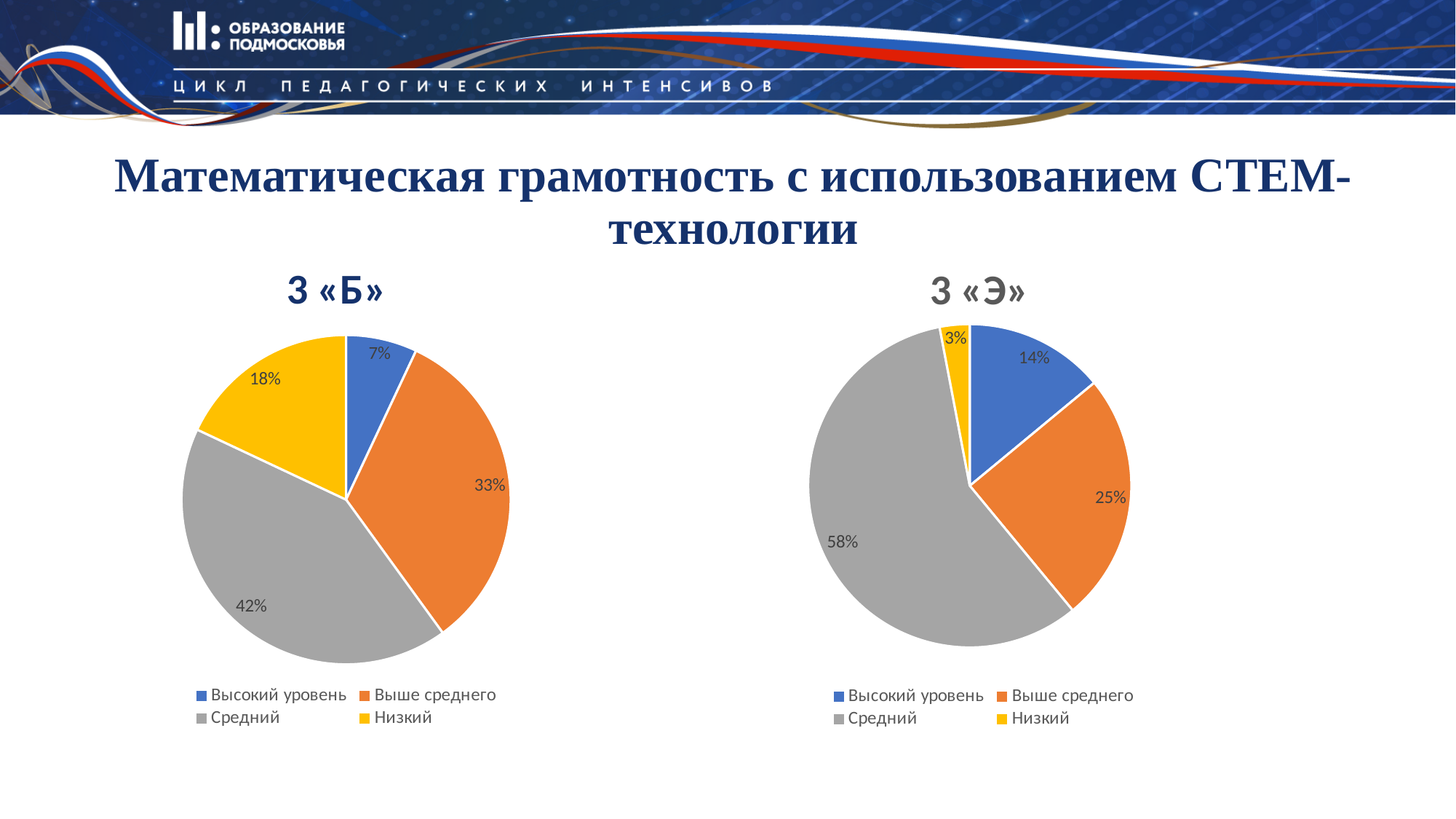
In the 3 «Б» pie chart, which category has the largest share? Средний Which is larger: the Высокий уровень share in the 3 «Б» chart or in the 3 «Э» chart? 3 «Э» In the 3 «Б» chart, what colour represents Низкий? Yellow In the 3 «Э» pie chart, what share is labelled for Высокий уровень? 14% How many categories does the legend of the 3 «Э» chart list? 4 In the 3 «Б» pie chart, what share is labelled for Низкий? 18% In the 3 «Э» pie chart, which category has the smallest share? Низкий In the 3 «Б» pie chart, which category has the smallest share? Высокий уровень What type of chart is used for 3 «Б»? Pie chart In the 3 «Б» pie chart, what share is labelled for Средний? 42% What is the difference between the Средний shares in the 3 «Э» chart and the 3 «Б» chart? 16% In the 3 «Э» pie chart, what share is labelled for Выше среднего? 25%